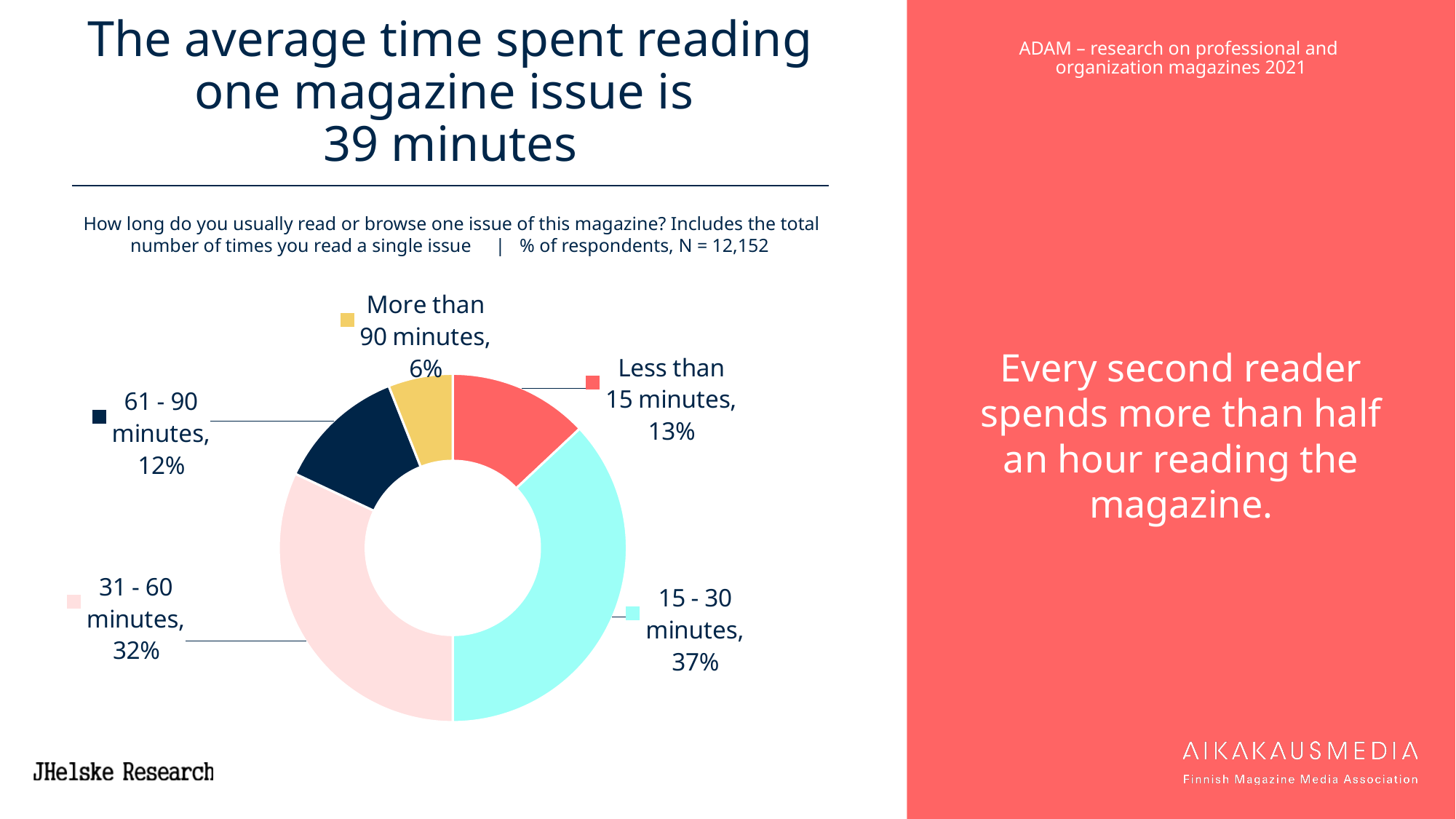
What percentage of respondents read one issue for 15 - 30 minutes? 37% What percentage of respondents read one issue for 61 - 90 minutes? 12% What is the difference in percentage points between the 15 - 30 minutes and 31 - 60 minutes categories? 5 How many reading-time categories are shown in the chart? 5 What kind of chart is used on the slide? Doughnut (pie) chart Which reading-time category has the largest share of respondents? 15 - 30 minutes Which reading-time category has the smallest share of respondents? More than 90 minutes What percentage of respondents read one issue for more than 90 minutes? 6% What percentage of respondents read one issue for less than 15 minutes? 13% What colour is the slice for the 15 - 30 minutes category? Light blue (cyan) What is the combined share of respondents who read for 31 - 60 minutes or 61 - 90 minutes? 44% Which category has a larger share: less than 15 minutes or 61 - 90 minutes? Less than 15 minutes